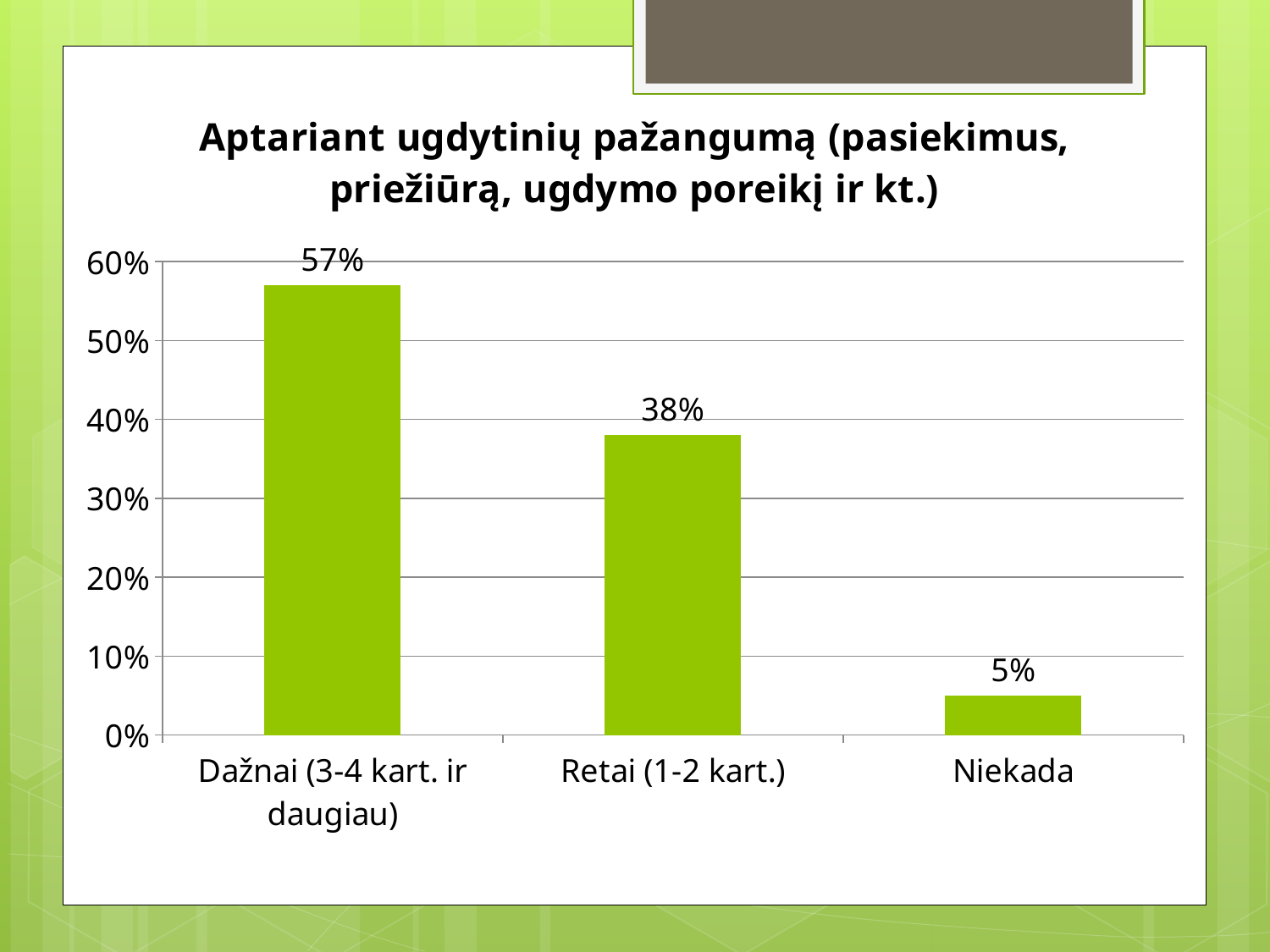
What is the value for "Dažnai (3-4 kart. ir daugiau)"? 57% How many categories are shown on the x axis? 3 What is the difference between the values for "Retai (1-2 kart.)" and "Niekada"? 33% What is the value for "Niekada"? 5% Which category has the highest value? Dažnai (3-4 kart. ir daugiau) What is the difference between the values for "Dažnai (3-4 kart. ir daugiau)" and "Retai (1-2 kart.)"? 19% Which category has the lowest value? Niekada What kind of chart is shown on the slide? Bar chart Do the values rise or fall from left to right along the x axis? Fall Which is larger, the value for "Retai (1-2 kart.)" or the value for "Niekada"? Retai (1-2 kart.) What is the value for "Retai (1-2 kart.)"? 38% Is the value for "Retai (1-2 kart.)" greater or less than 40%? less